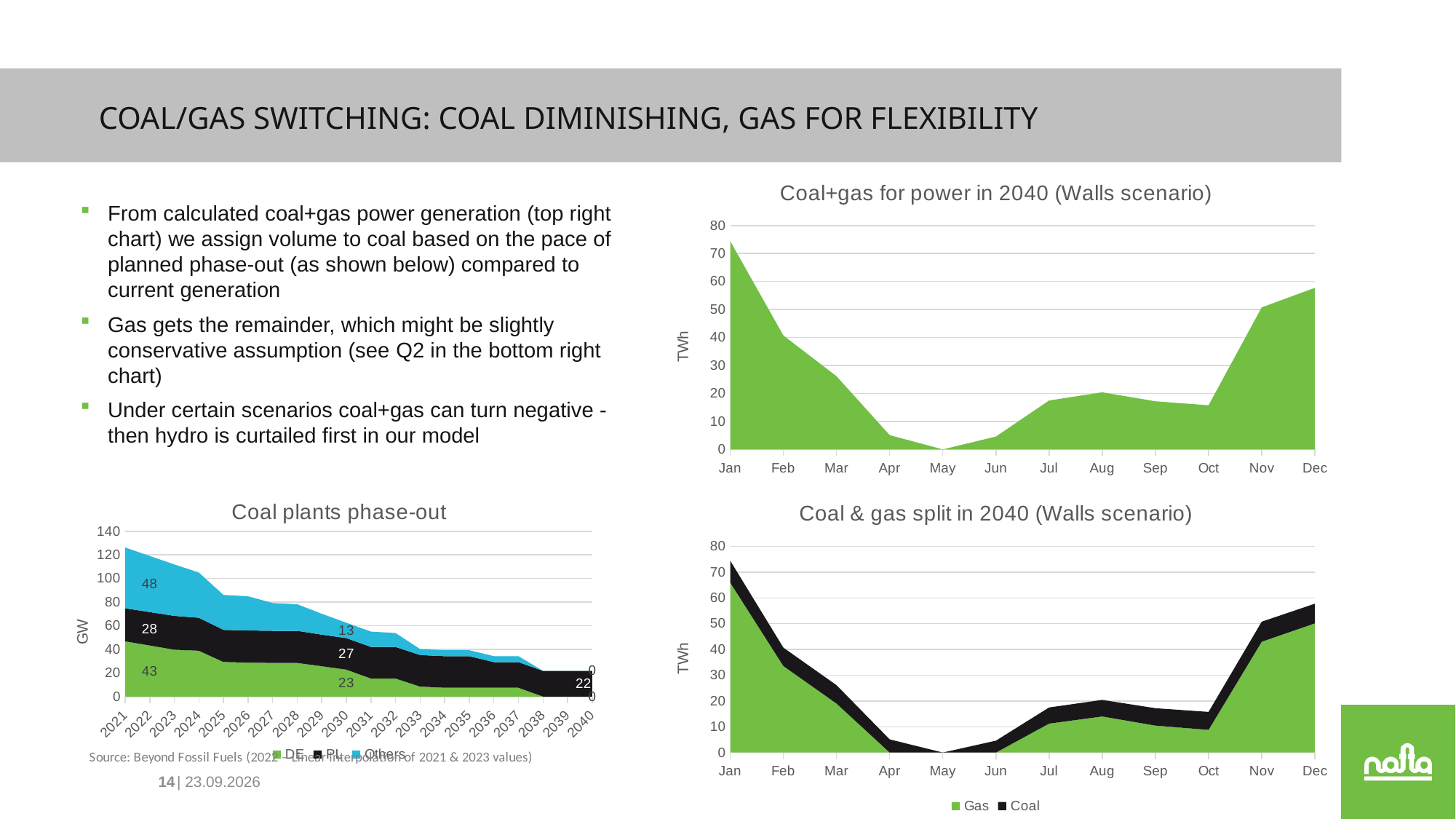
How many series does the legend of the 'Coal plants phase-out' chart list? 3 In the 'Coal plants phase-out' chart, what is the total of the stacked values in 2030? 63 In the 'Coal+gas for power in 2040 (Walls scenario)' chart, do the values rise or fall from Jan to May? fall In the 'Coal plants phase-out' chart, what is the difference between the Others value in 2022 and in 2030? 35 In the 'Coal+gas for power in 2040 (Walls scenario)' chart, is the value for Nov greater or less than 40? greater What are the two series listed in the legend of the 'Coal & gas split in 2040 (Walls scenario)' chart? Gas and Coal In the 'Coal plants phase-out' chart, what is the value for PL in 2030? 27 In the 'Coal+gas for power in 2040 (Walls scenario)' chart, which month has the lowest value? May In the 'Coal plants phase-out' chart, what is the value for Others in 2022? 48 In the 'Coal+gas for power in 2040 (Walls scenario)' chart, which month has the highest value? Jan In the 'Coal plants phase-out' chart, which is larger in 2022, DE or PL? DE In the 'Coal plants phase-out' chart, what is the value for DE in 2022? 43